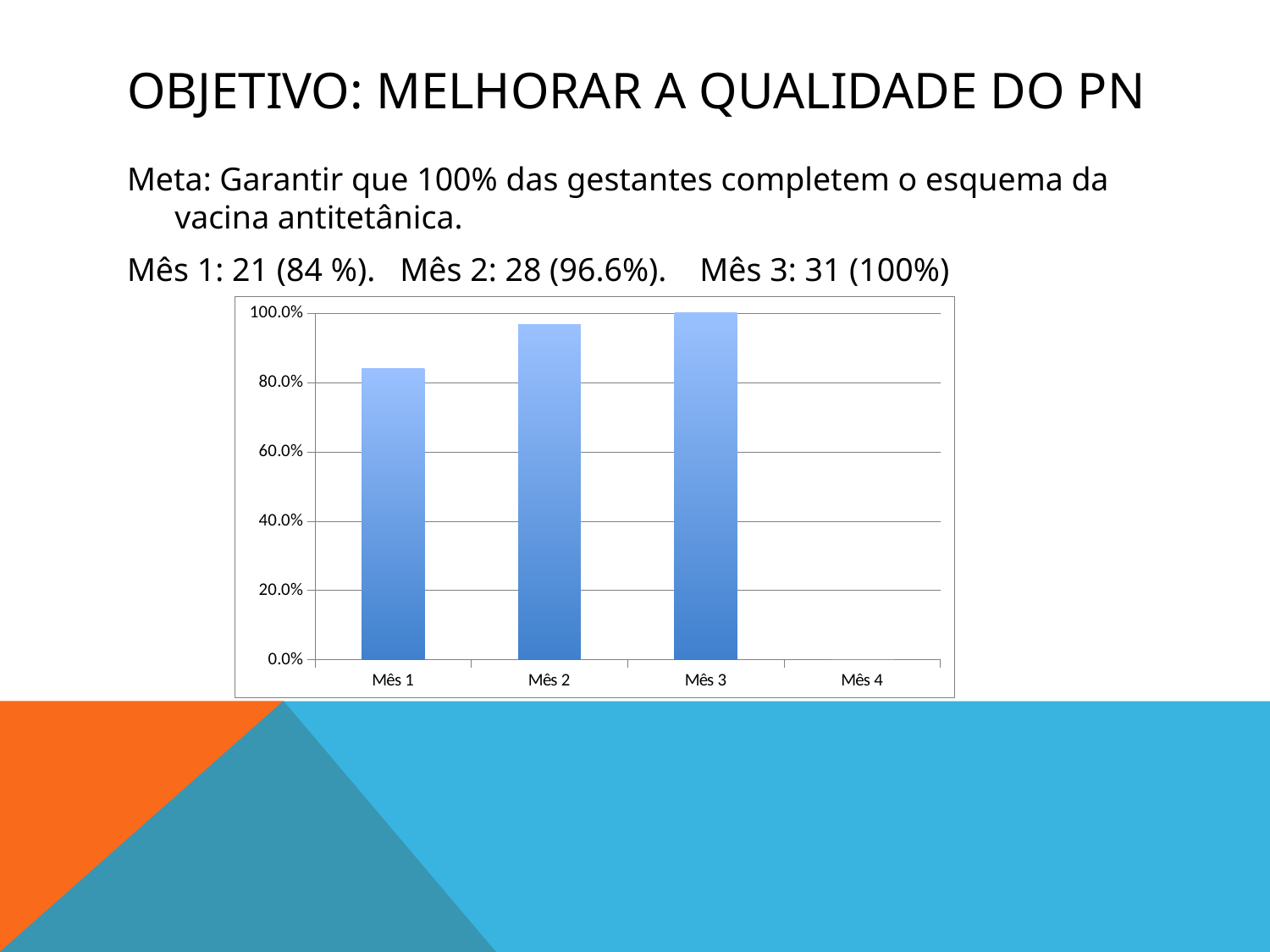
Is the value for Mês 1 greater or less than 100.0%? less Which month has the highest bar in the chart? Mês 3 Which category on the x axis has no bar plotted? Mês 4 Do the bar values rise or fall from Mês 1 to Mês 3? rise How many bars are plotted in the chart? 3 What kind of chart is shown on the slide? bar chart What is the value for Mês 3 in the chart? 100.0% Is the value for Mês 2 greater or less than 100.0%? less Is the value for Mês 1 greater or less than 80.0%? greater Which is larger, the value for Mês 1 or the value for Mês 2? Mês 2 Among the months with a plotted bar, which has the lowest value? Mês 1 How many categories are labelled on the x axis of the chart? 4